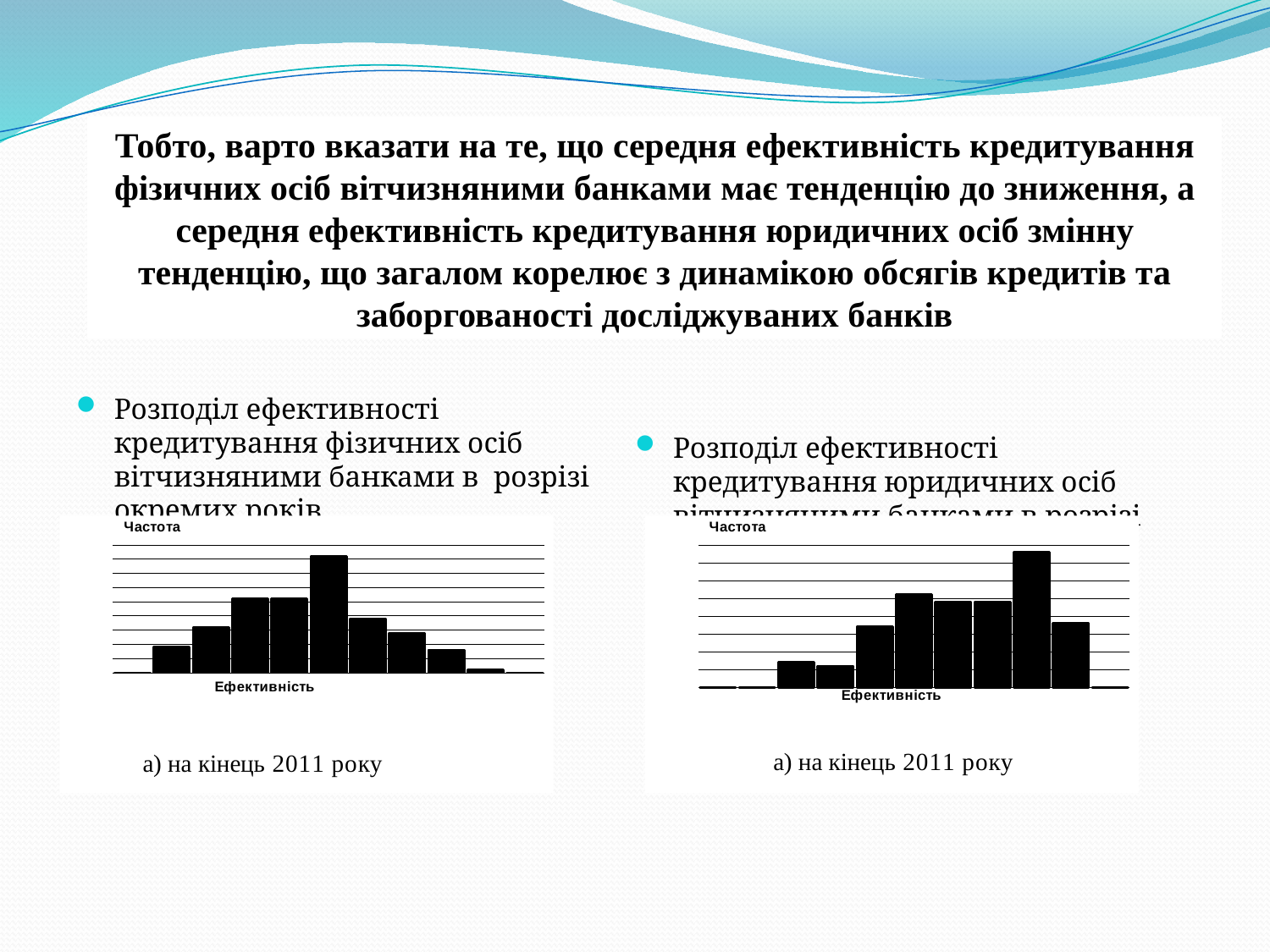
What is the label of the horizontal axis on the right chart? Ефективність What is the label of the vertical axis on the left chart? Частота What kind of chart is the right chart (Розподіл ефективності кредитування юридичних осіб)? bar chart In the left chart, do the bar heights rise or fall moving from the tallest bar toward the right end of the axis? fall In the right chart, do the bar heights generally rise or fall moving from the left end of the axis toward the tallest bar? rise What kind of chart is the left chart (Розподіл ефективності кредитування фізичних осіб)? bar chart In the right chart, which bar is taller: the tallest bar near the right end or the first visible bar on the left? the tallest bar near the right end In the left chart, which bar is taller: the fifth bar from the left or the first bar from the left? the fifth bar from the left